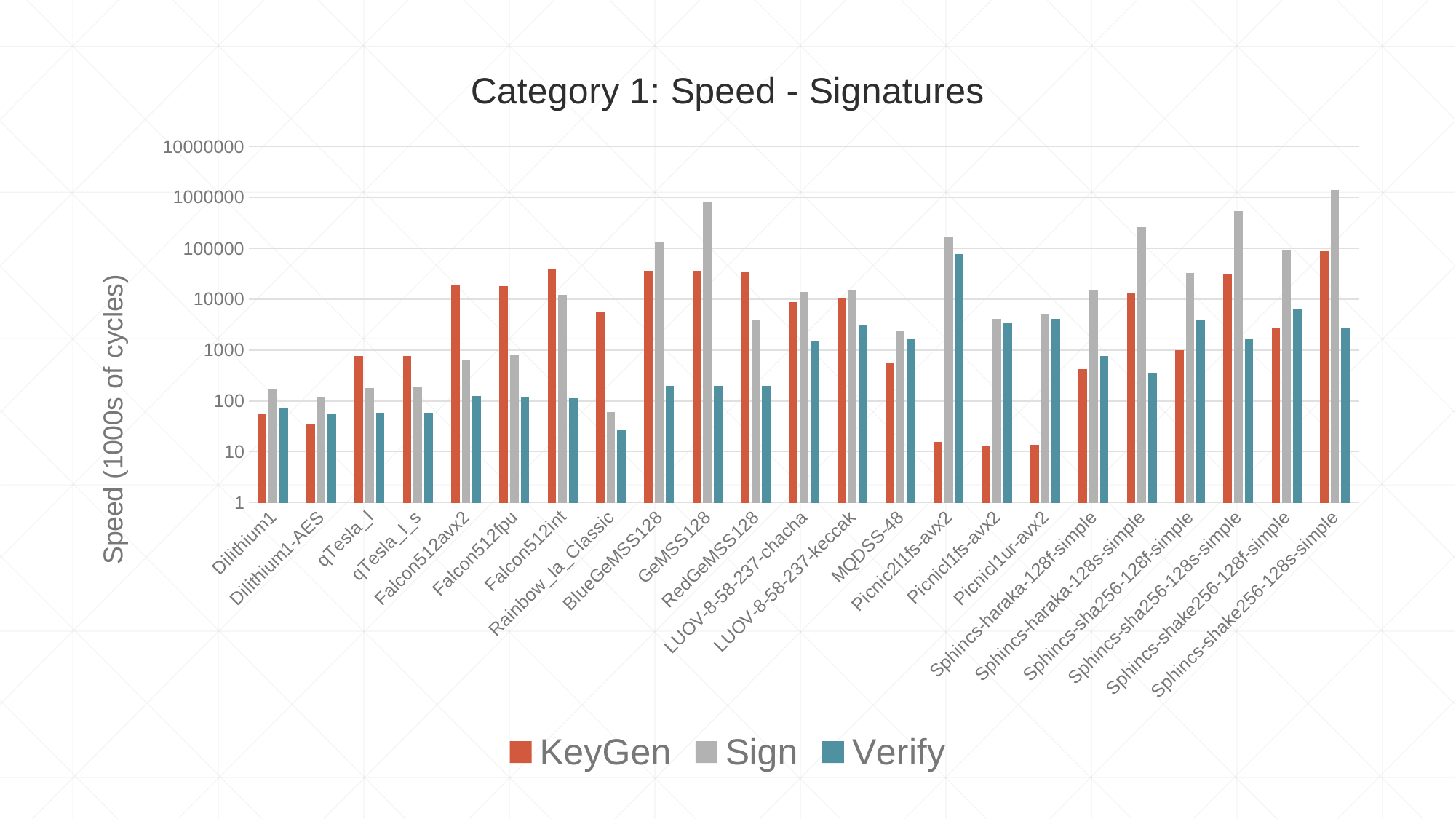
Is the Sign value for GeMSS128 greater or less than 100000? greater Which scheme has the lowest Verify value? Rainbow_Ia_Classic Is the KeyGen value for Dilithium1 greater or less than 100? less Which scheme has the lowest Sign value? Rainbow_Ia_Classic Which scheme has the highest Sign value? Sphincs-shake256-128s-simple Which scheme has the highest Verify value? Picnic2l1fs-avx2 How many series does the legend list? 3 What is the title of the chart? Category 1: Speed - Signatures What kind of chart is shown on the slide? bar chart How many signature schemes (categories) are shown on the x axis? 23 Which scheme has the highest KeyGen value? Sphincs-shake256-128s-simple For Rainbow_Ia_Classic, which is larger: the KeyGen value or the Sign value? KeyGen